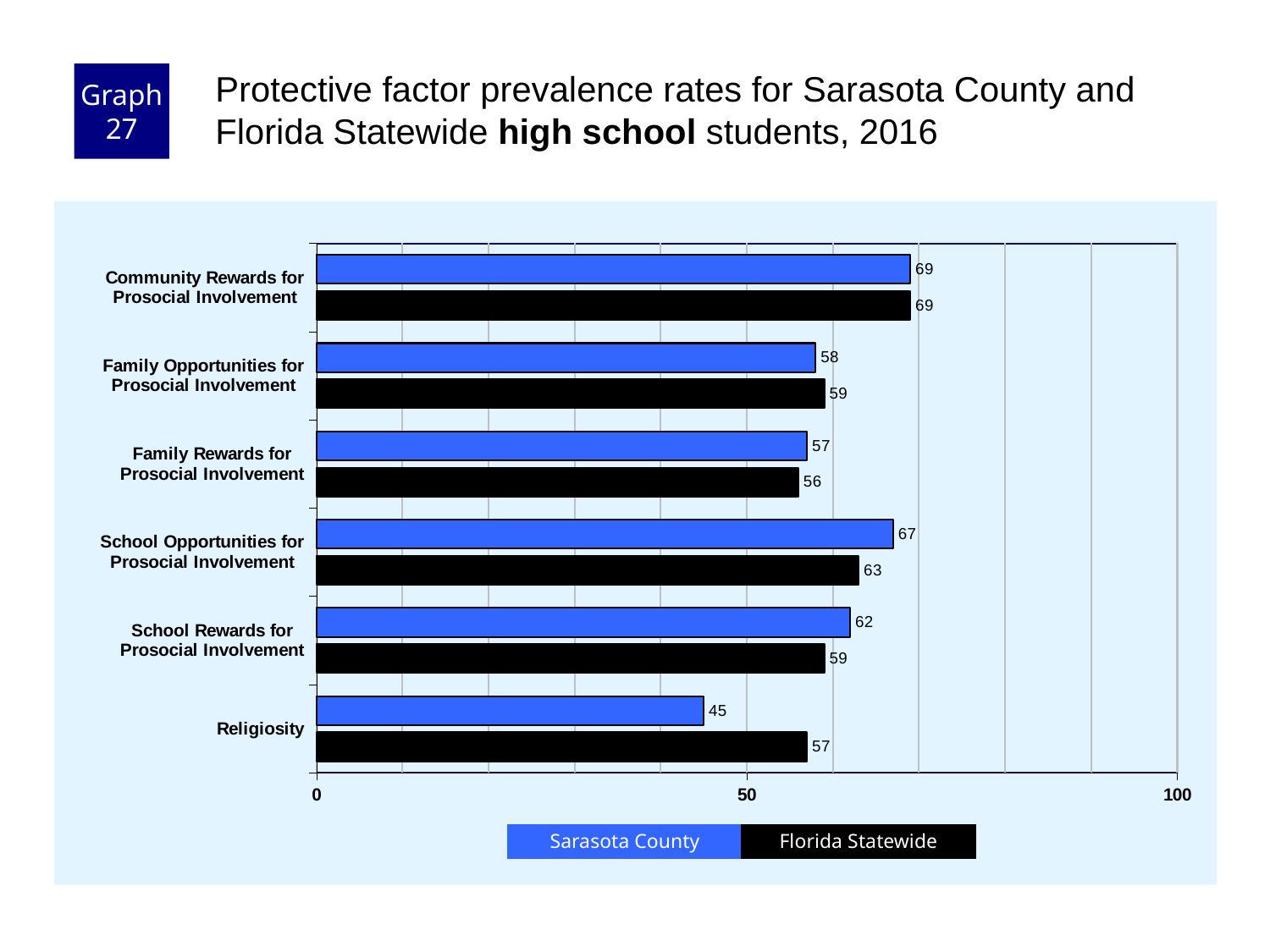
Which category has the lowest Sarasota County value? Religiosity What is the Florida Statewide value for Religiosity? 57 What kind of chart is shown on the slide? bar chart Is the Sarasota County value for Religiosity greater or less than 50? less What is the Sarasota County value for Community Rewards for Prosocial Involvement? 69 Which is larger for School Rewards for Prosocial Involvement, the Sarasota County value or the Florida Statewide value? Sarasota County What is the difference between the Sarasota County and Florida Statewide values for School Opportunities for Prosocial Involvement? 4 How many series does the legend list? 2 What is the difference between the Florida Statewide and Sarasota County values for Religiosity? 12 What is the Sarasota County value for School Opportunities for Prosocial Involvement? 67 Which category has the highest Florida Statewide value? Community Rewards for Prosocial Involvement How many categories are shown on the chart? 6